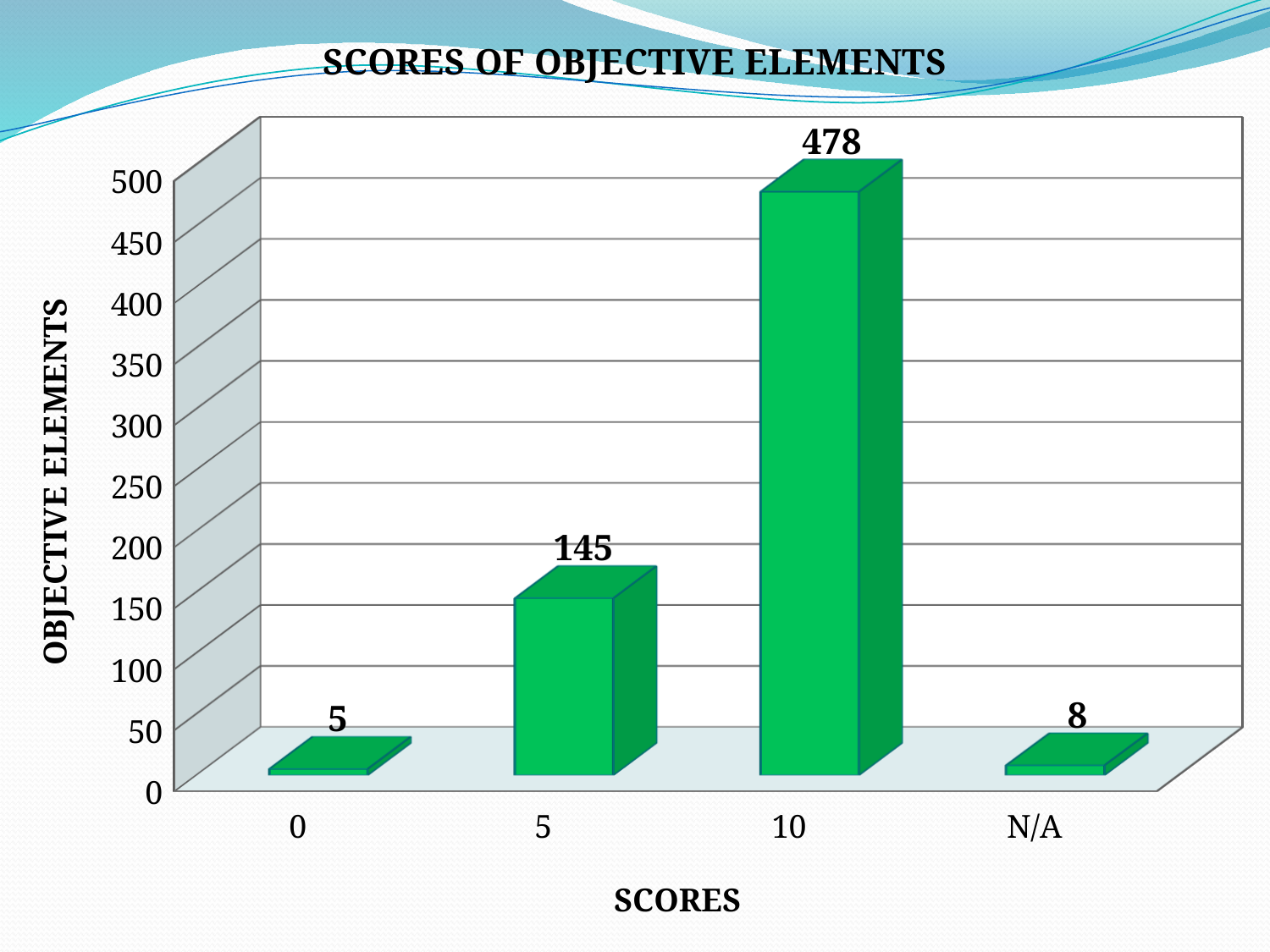
How many categories are shown on the x axis? 4 Which is larger, the value for N/A or the value for score 0? N/A Which score category has the highest value? 10 What kind of chart is shown on the slide? Bar chart What is the value for the score category 10? 478 What is the difference between the values for score 10 and score 5? 333 What is the label of the y axis? OBJECTIVE ELEMENTS What is the value for the score category 0? 5 What is the title of the chart? SCORES OF OBJECTIVE ELEMENTS Which score category has the lowest value? 0 What is the value for the N/A category? 8 What is the value for the score category 5? 145